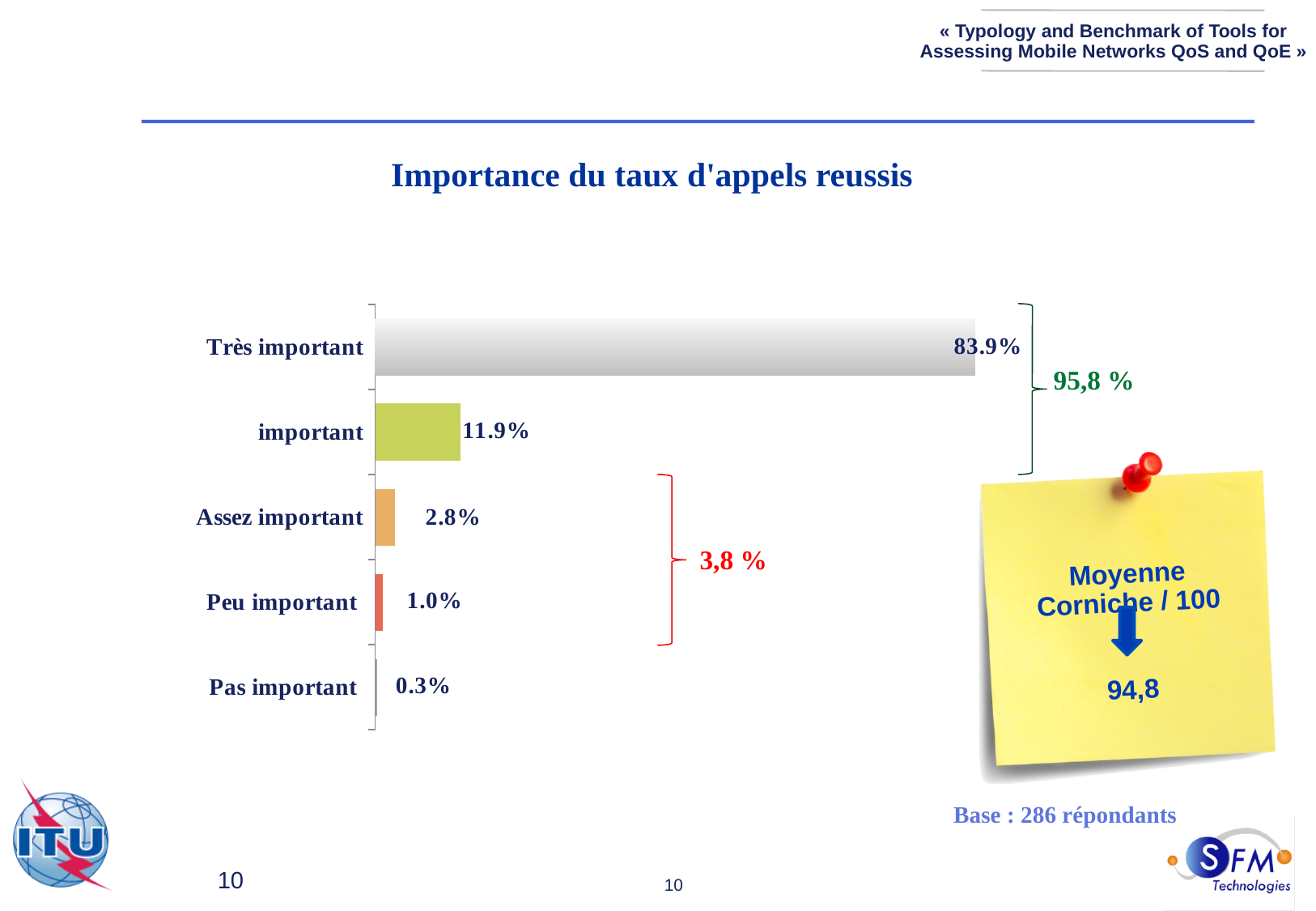
Which is larger, the value for "Assez important" or the value for "Peu important"? Assez important Which category has the lowest value? Pas important What is the value for "important"? 11.9% What is the value for "Très important"? 83.9% What is the value for "Peu important"? 1.0% What is the title of the chart? Importance du taux d'appels reussis What kind of chart is shown on the slide? Bar chart What is the difference between the values for "Très important" and "important"? 72.0% Which category has the highest value? Très important What is the value for "Pas important"? 0.3% How many categories are shown in the chart? 5 What is the value for "Assez important"? 2.8%